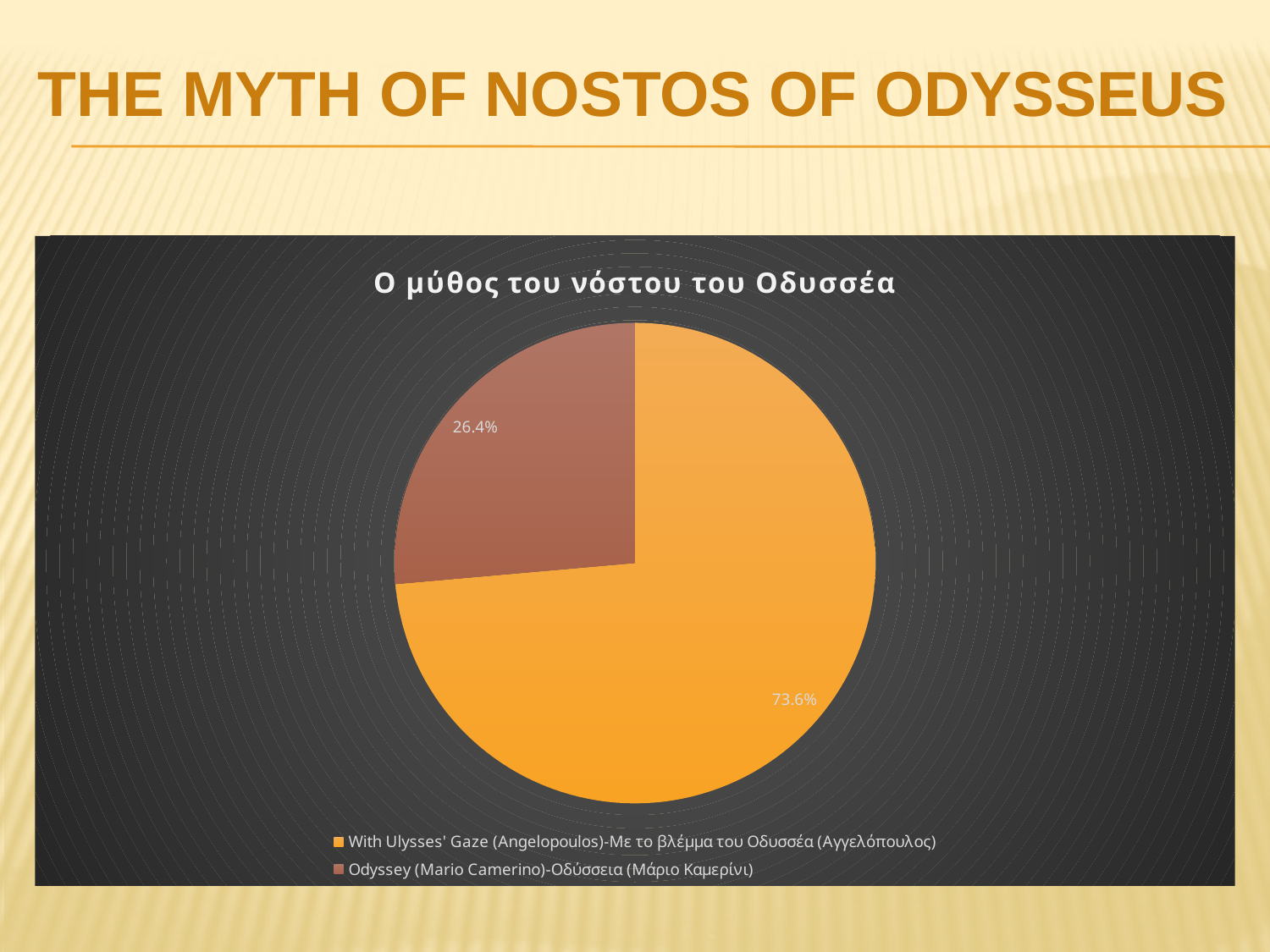
What colour is the slice for With Ulysses' Gaze (Angelopoulos)? Orange What is the difference in percentage points between the With Ulysses' Gaze slice and the Odyssey (Mario Camerino) slice? 47.2 How many entries does the legend list? 2 Which slice is the smallest in the pie chart? Odyssey (Mario Camerino) How many slices does the pie chart have? 2 What share of the pie does the slice for With Ulysses' Gaze (Angelopoulos) represent? 73.6% Which slice is the largest in the pie chart? With Ulysses' Gaze (Angelopoulos) What share of the pie does the slice for Odyssey (Mario Camerino) represent? 26.4% Which is larger: the slice for Odyssey (Mario Camerino) or the slice for With Ulysses' Gaze (Angelopoulos)? With Ulysses' Gaze (Angelopoulos) What kind of chart is shown on the slide? Pie chart What is the title of the chart? Ο μύθος του νόστου του Οδυσσέα